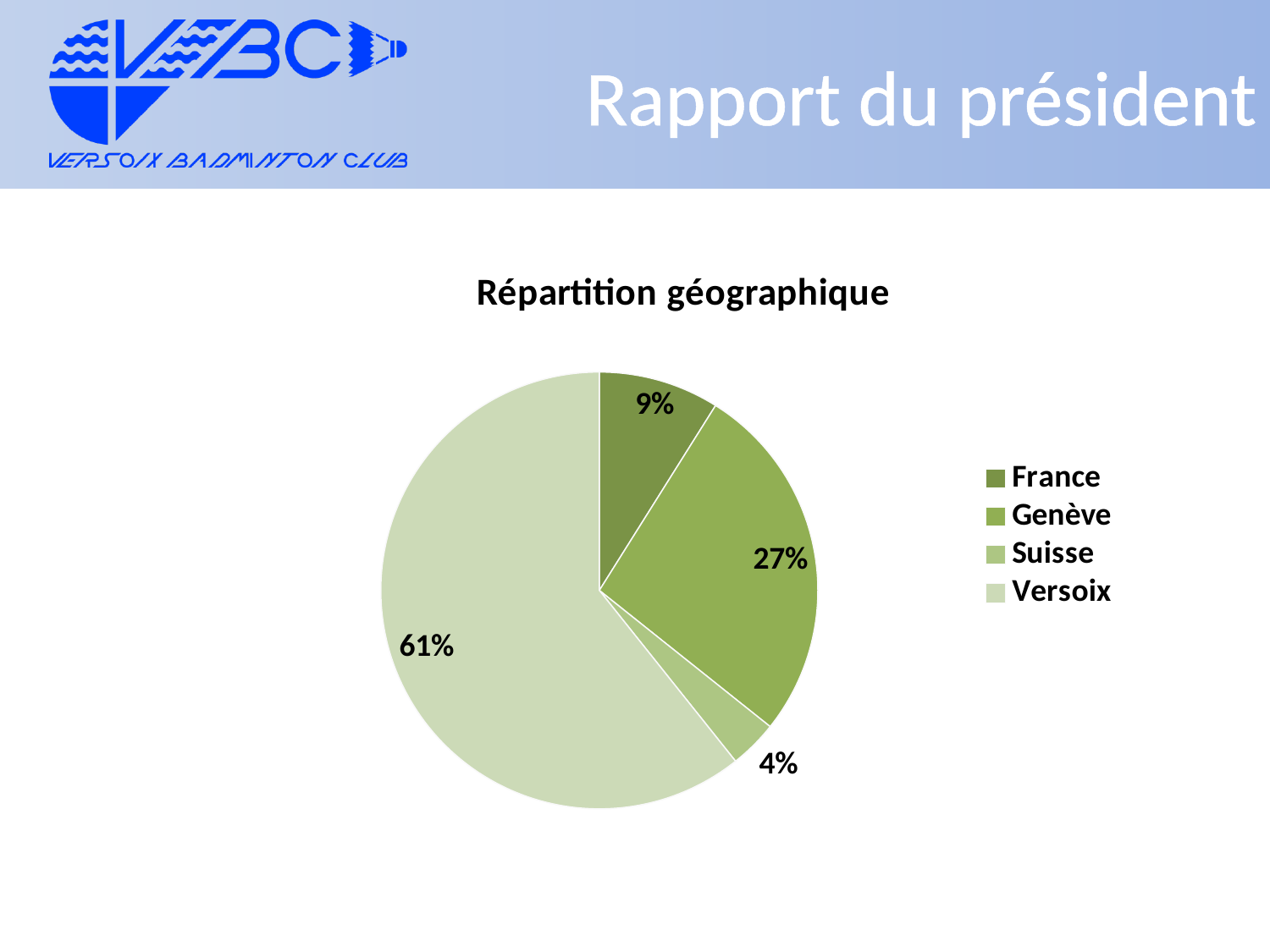
What is the difference in percentage points between the Versoix and Genève slices? 34 What kind of chart is shown on the slide? Pie chart Which slice is larger, France or Genève? Genève What share of the pie does Genève represent? 27% What is the difference in percentage points between the France and Suisse slices? 5 What share of the pie does France represent? 9% Which category has the largest slice of the pie? Versoix What share of the pie does Versoix represent? 61% How many categories are shown in the pie chart? 4 What is the title of the chart? Répartition géographique Which category has the smallest slice of the pie? Suisse